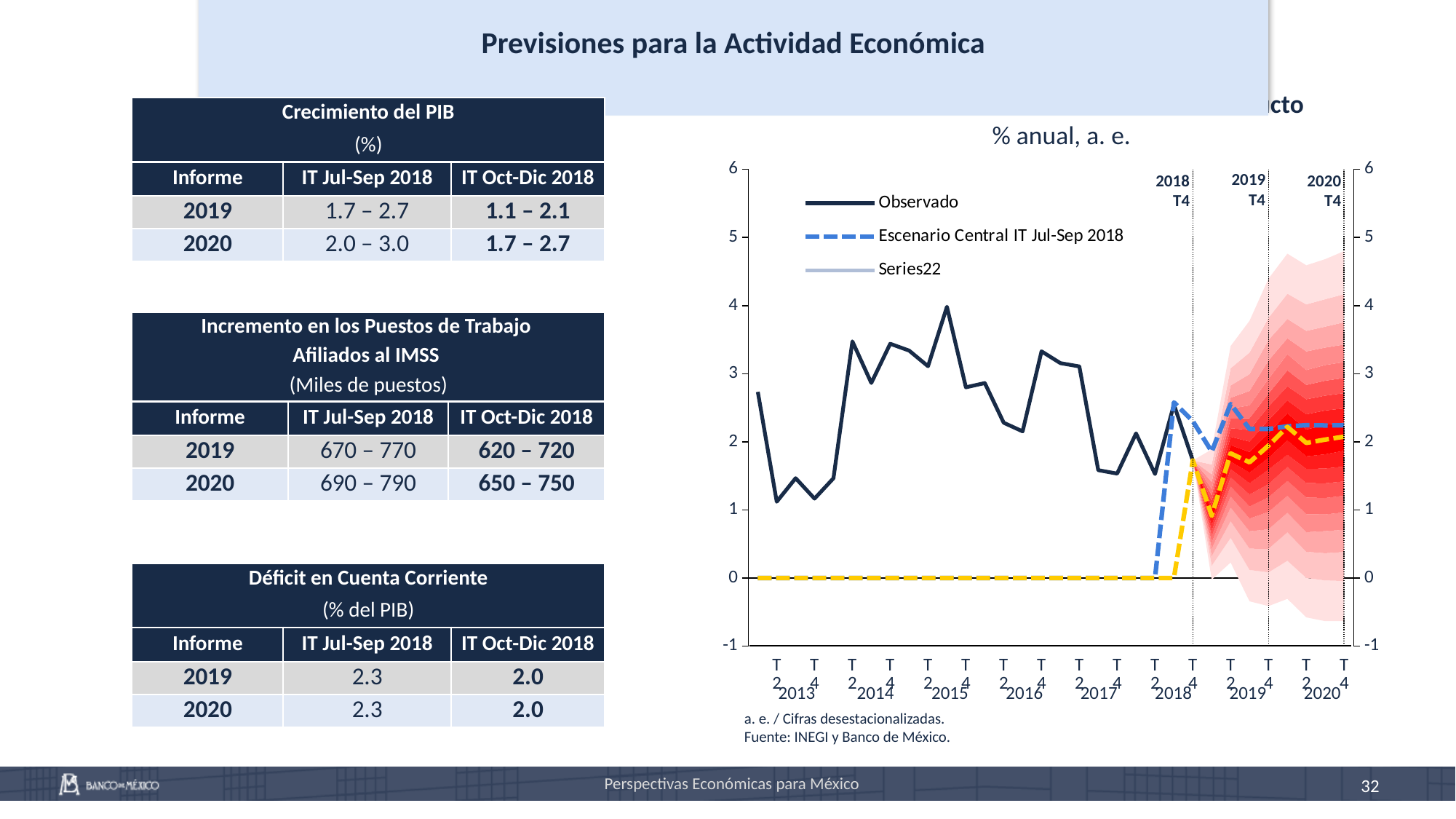
Is the Observado value at T4 2017 greater or less than 2? less Does the Observado line rise or fall between T2 2015 and T2 2016? fall How many series does the legend of the chart list? 3 What is the subtitle (units) shown above the chart? % anual, a. e. Is the Escenario Central IT Jul-Sep 2018 value at T4 2018 greater or less than 2? greater Is the Observado value at T2 2014 greater or less than 3? greater What kind of chart is shown on the right side of the slide? line chart What is the lowest value shown on the chart's vertical axis? -1 What is the highest value shown on the chart's vertical axis? 6 What is the name of the first series listed in the chart's legend? Observado